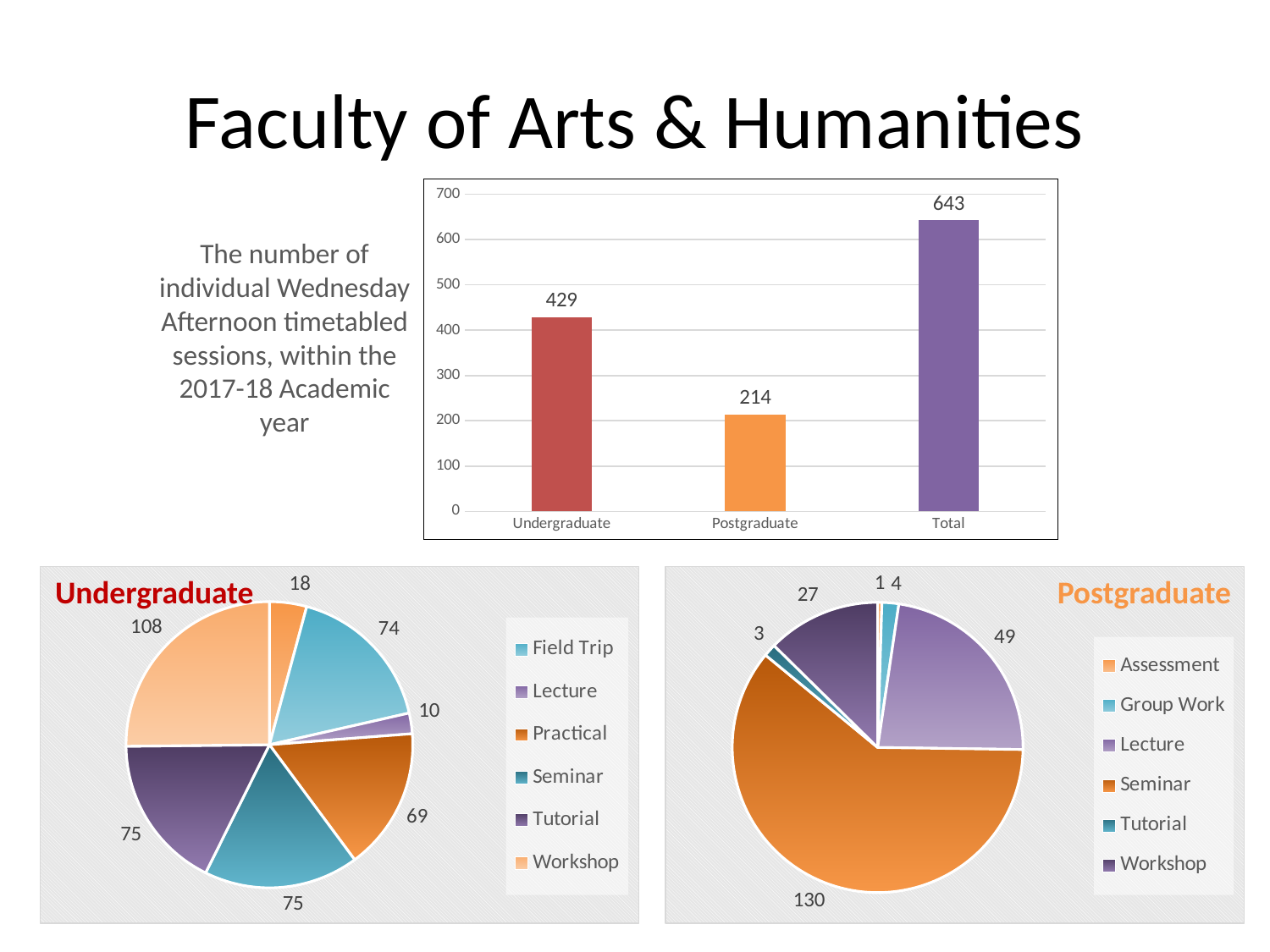
In the Postgraduate pie chart, which is larger, Lecture or Workshop? Lecture In the Postgraduate pie chart, what is the value for Seminar? 130 In the Undergraduate pie chart, what is the value for Field Trip? 74 In the Undergraduate pie chart, what is the value for Workshop? 108 In the Undergraduate pie chart, which legend category has the smallest slice? Lecture In the bar chart at the top of the slide, how many sessions are shown for Postgraduate? 214 In the bar chart at the top of the slide, what is the difference between the Undergraduate and Postgraduate values? 215 In the bar chart at the top of the slide, how many sessions are shown for Undergraduate? 429 In the bar chart at the top of the slide, which category has the tallest bar? Total How many bars are in the bar chart at the top of the slide? 3 In the Postgraduate pie chart, which category has the largest slice? Seminar What type of chart is the chart at the top of the slide? Bar chart